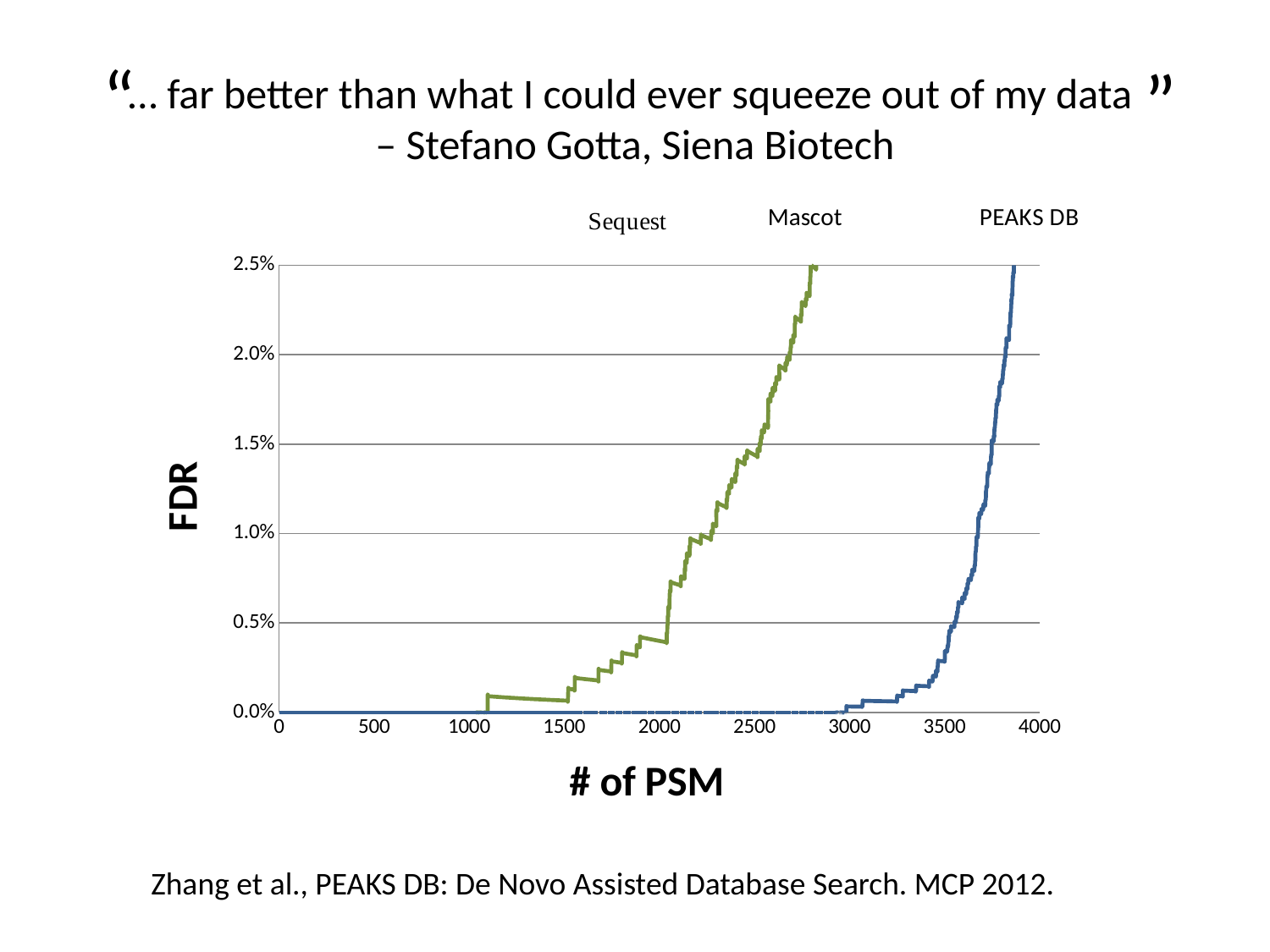
Is the FDR of the PEAKS DB line at 3500 PSMs greater or less than 0.5%? less Is the FDR of the PEAKS DB line at 3000 PSMs greater or less than 0.5%? less Does the FDR rise or fall as the number of PSMs increases along the x axis? rise Is the FDR of the Mascot line at 1500 PSMs greater or less than 0.5%? less What is the highest value shown on the x-axis of the chart? 4000 Which series reaches an FDR of 2.5% at a larger number of PSMs, Mascot or PEAKS DB? PEAKS DB What is the highest value shown on the y-axis of the chart? 2.5% What is the title of the x-axis of the chart? # of PSM How many series labels are shown above the chart? 3 What kind of chart is shown on the slide? line chart What is the title of the y-axis of the chart? FDR